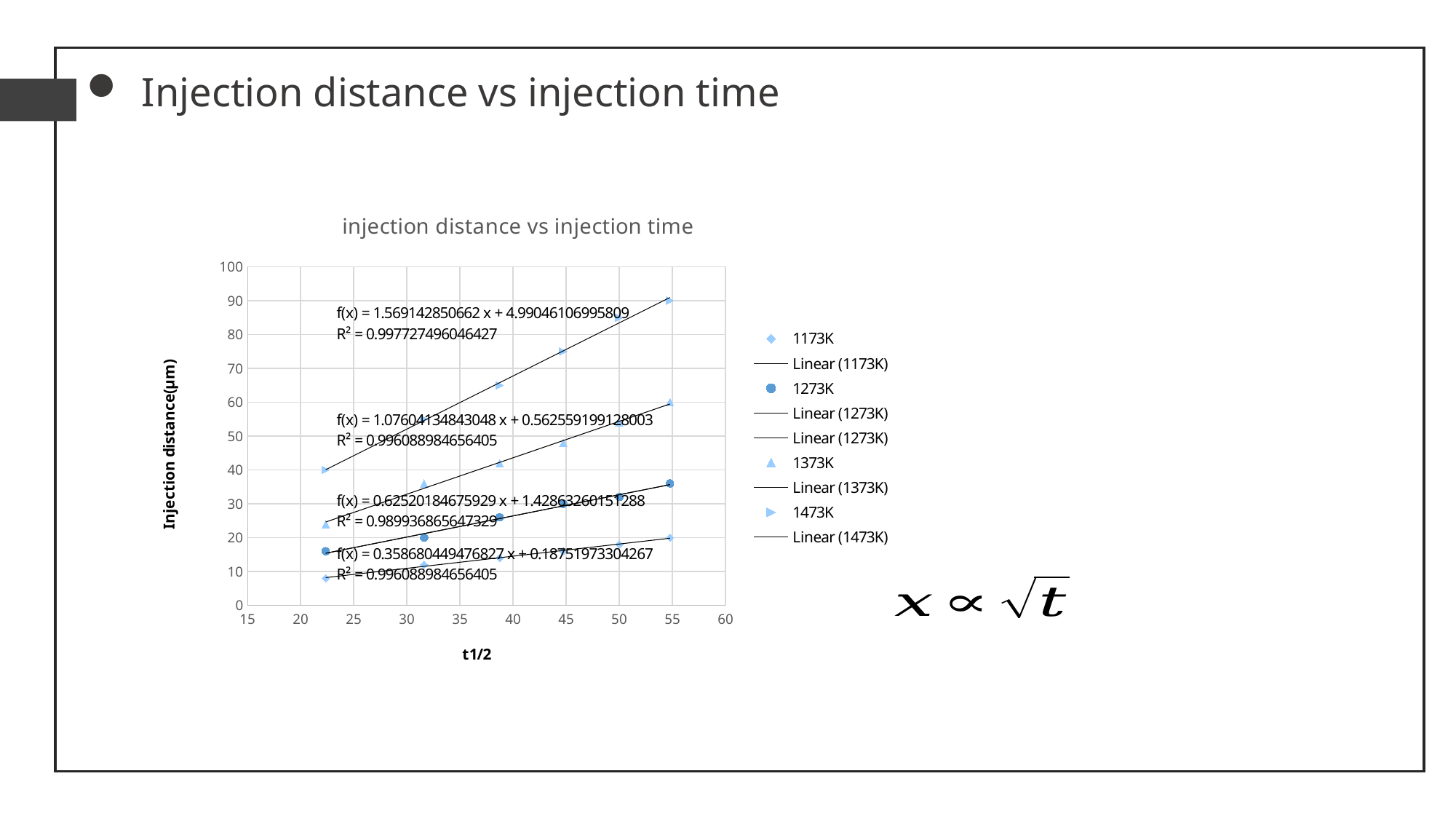
Which temperature series has the lowest injection distance values? 1173K Do the injection distance values for the 1473K series rise or fall as t1/2 increases? rise What R² value is printed for the topmost trendline equation on the chart? 0.997727496046427 How many temperature data series (marker series) are plotted on the chart? 4 Is the injection distance for the 1373K series at its rightmost point (t1/2 about 55) greater or less than 50? greater What kind of chart is shown on the slide? scatter chart Which temperature series has the highest injection distance values? 1473K What is the title of the chart? injection distance vs injection time Is the injection distance for the 1473K series at its rightmost point (t1/2 about 55) greater or less than 80? greater Is the injection distance for the 1173K series at its rightmost point (t1/2 about 55) greater or less than 30? less How many entries does the chart legend list? 9 At the rightmost data points (t1/2 about 55), which series has the larger injection distance, 1373K or 1273K? 1373K